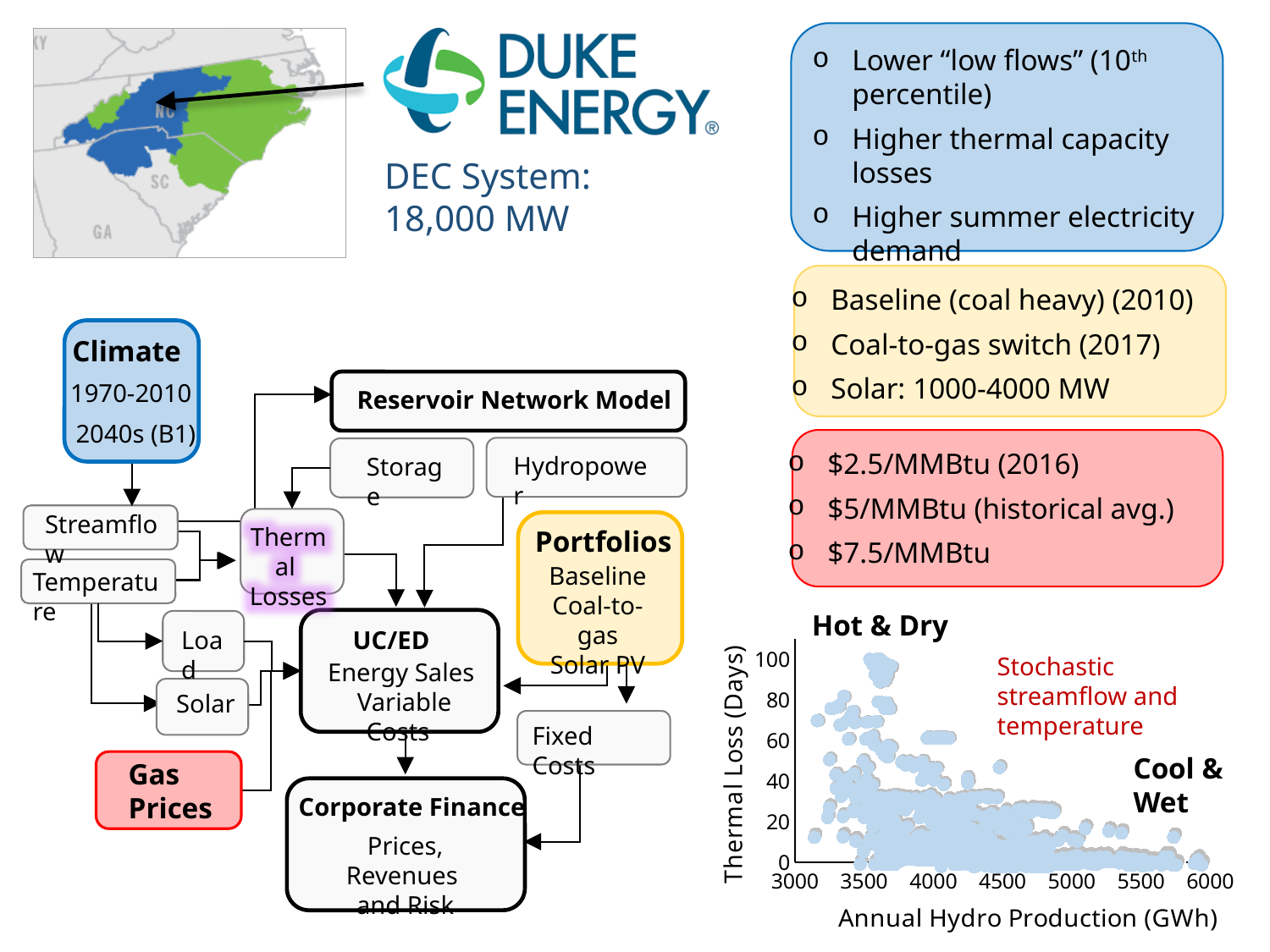
In the bottom-right chart, does thermal loss rise or fall as annual hydro production increases? fall In the bottom-right chart, is the highest thermal loss value plotted greater or less than 80 days? greater In the bottom-right chart, are the thermal loss values at around 5500 GWh of annual hydro production greater or less than 40 days? less What is the label of the y axis of the bottom-right chart? Thermal Loss (Days) What is the label of the x axis of the bottom-right chart? Annual Hydro Production (GWh) What kind of chart is shown at the bottom right of the slide? scatter plot